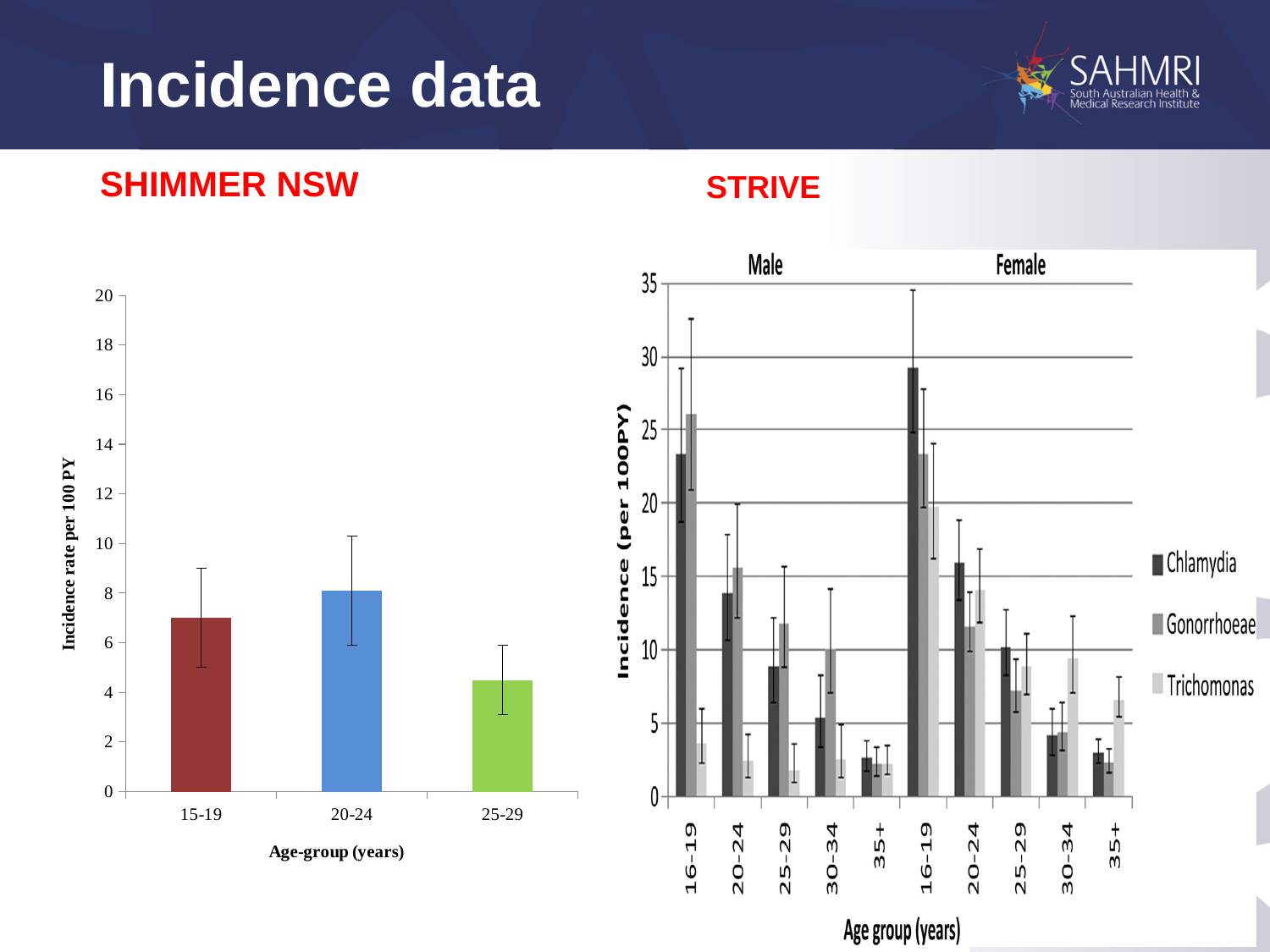
What is the y-axis label of the SHIMMER NSW chart? Incidence rate per 100 PY In the SHIMMER NSW chart, which is larger, the incidence rate for 15-19 or for 25-29? 15-19 What kind of chart is the SHIMMER NSW chart on the left? bar chart In the SHIMMER NSW chart, is the incidence rate for the 25-29 age group greater or less than 6? less In the STRIVE chart, which is larger, the Chlamydia incidence for females aged 16-19 or for females aged 20-24? females aged 16-19 How many series does the legend of the STRIVE chart list? 3 In the STRIVE chart, is the Chlamydia incidence for males aged 35+ greater or less than 5? less In the SHIMMER NSW chart, is the incidence rate for the 20-24 age group greater or less than 6? greater In the SHIMMER NSW chart, which age group has the lowest incidence rate? 25-29 In the SHIMMER NSW chart, which age group has the highest incidence rate? 20-24 How many age-group categories does the SHIMMER NSW chart show? 3